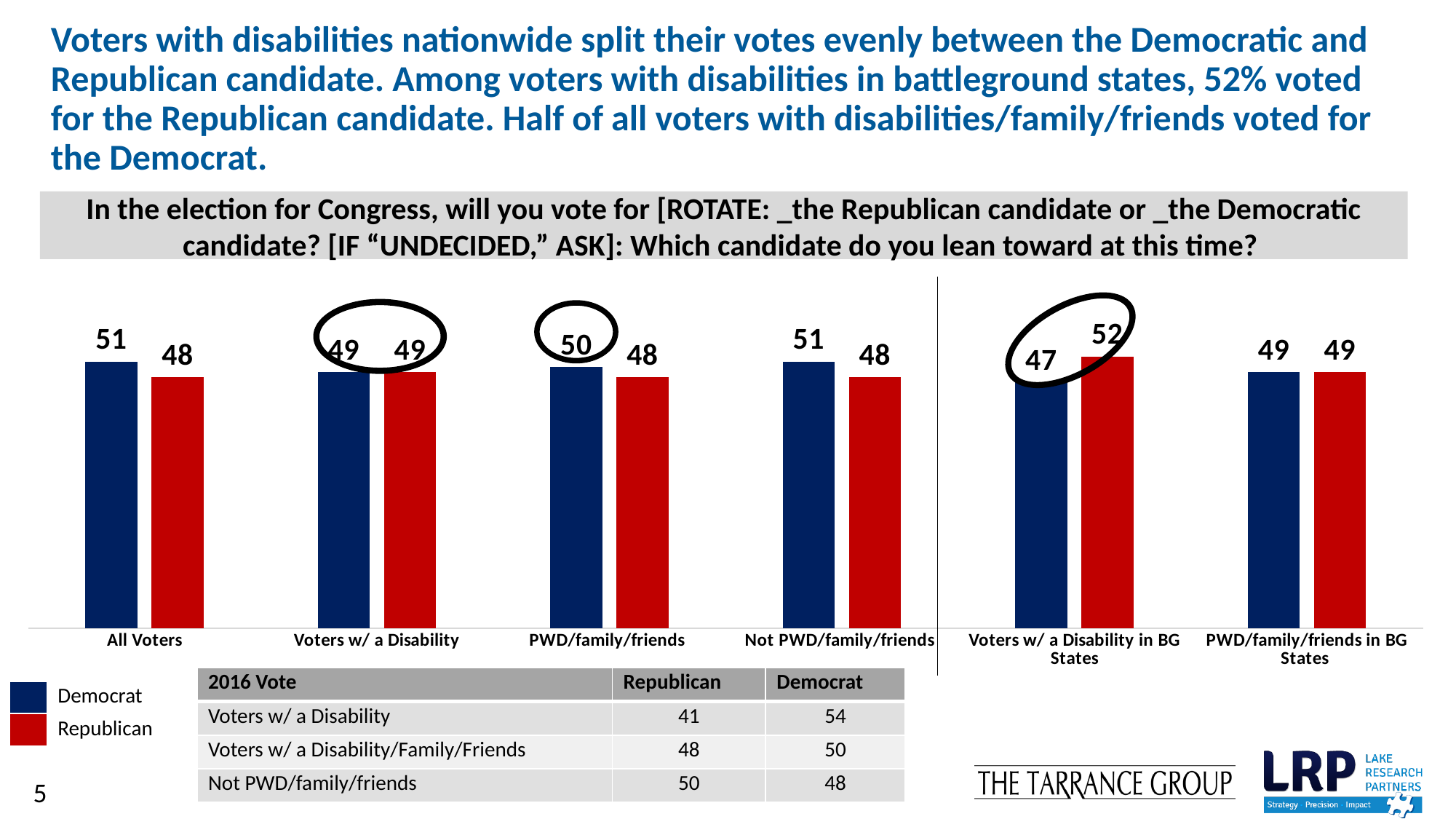
What is the Republican value for Not PWD/family/friends? 48 What is the difference between the Republican and Democrat values for Voters w/ a Disability in BG States? 5 What is the Republican value for Voters w/ a Disability in BG States? 52 What is the Democrat value for All Voters? 51 How many categories are shown on the x axis of the chart? 6 What is the Democrat value for PWD/family/friends? 50 For PWD/family/friends, which is larger, the Democrat value or the Republican value? Democrat Which category has the lowest Democrat value? Voters w/ a Disability in BG States What kind of chart is shown on the slide? Bar chart How many series does the legend list? 2 Which category has the highest Republican value? Voters w/ a Disability in BG States What is the difference between the Democrat and Republican values for All Voters? 3